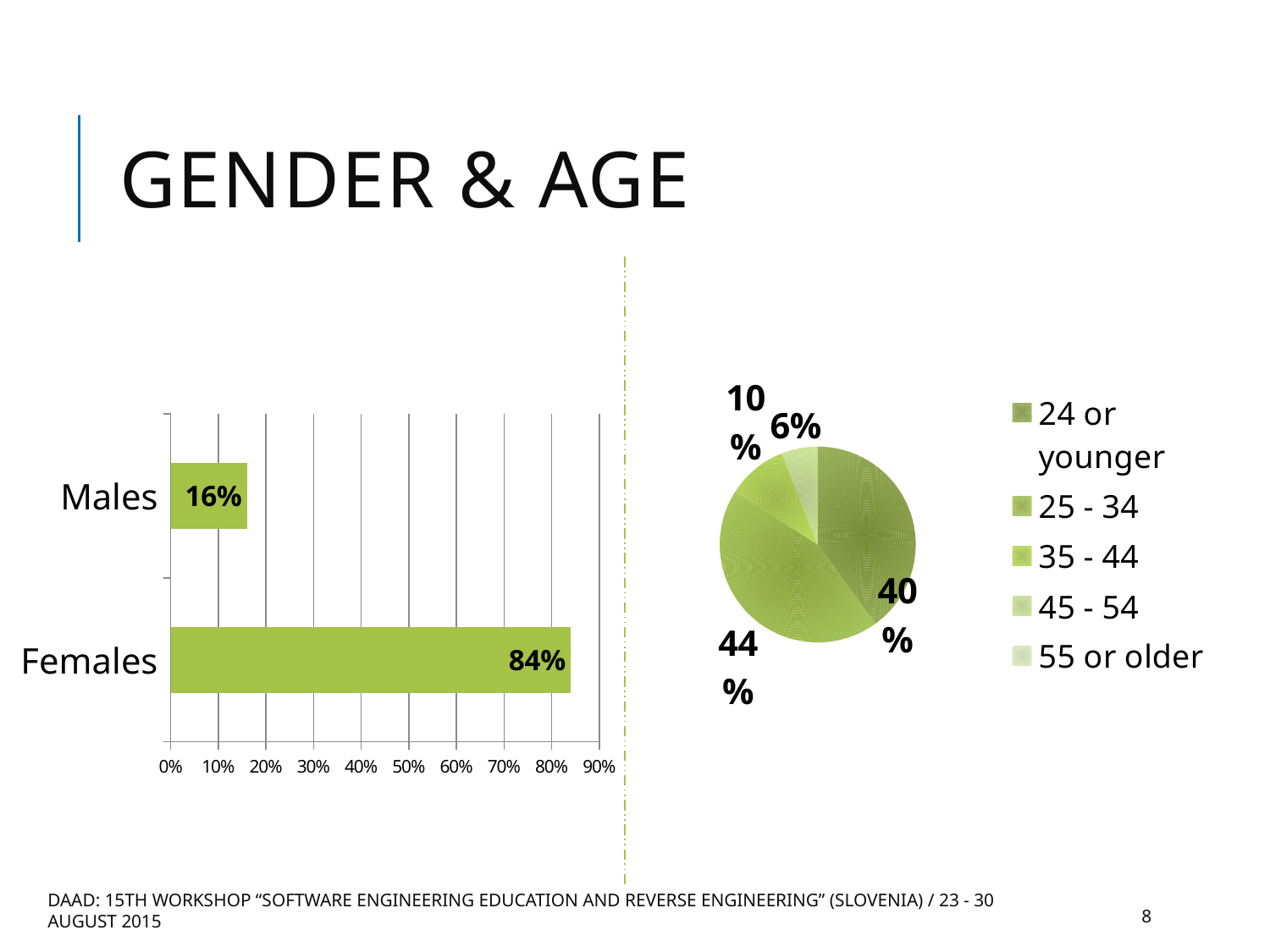
How many categories does the left bar chart show? 2 What kind of chart is shown on the left side of the slide? bar chart On the left bar chart, what is the difference between the Females and Males values? 68% On the right pie chart, what is the share of the smallest labelled slice? 6% On the left bar chart, is the value for Females greater or less than 80%? greater On the left bar chart, what is the value for Males? 16% On the right pie chart, what is the share of the largest slice? 44% On the left bar chart, which category has the higher value? Females On the right pie chart, what is the difference between the 44% slice and the 40% slice? 4% On the left bar chart, what is the value for Females? 84% How many entries does the legend of the right pie chart list? 5 What kind of chart is shown on the right side of the slide? pie chart